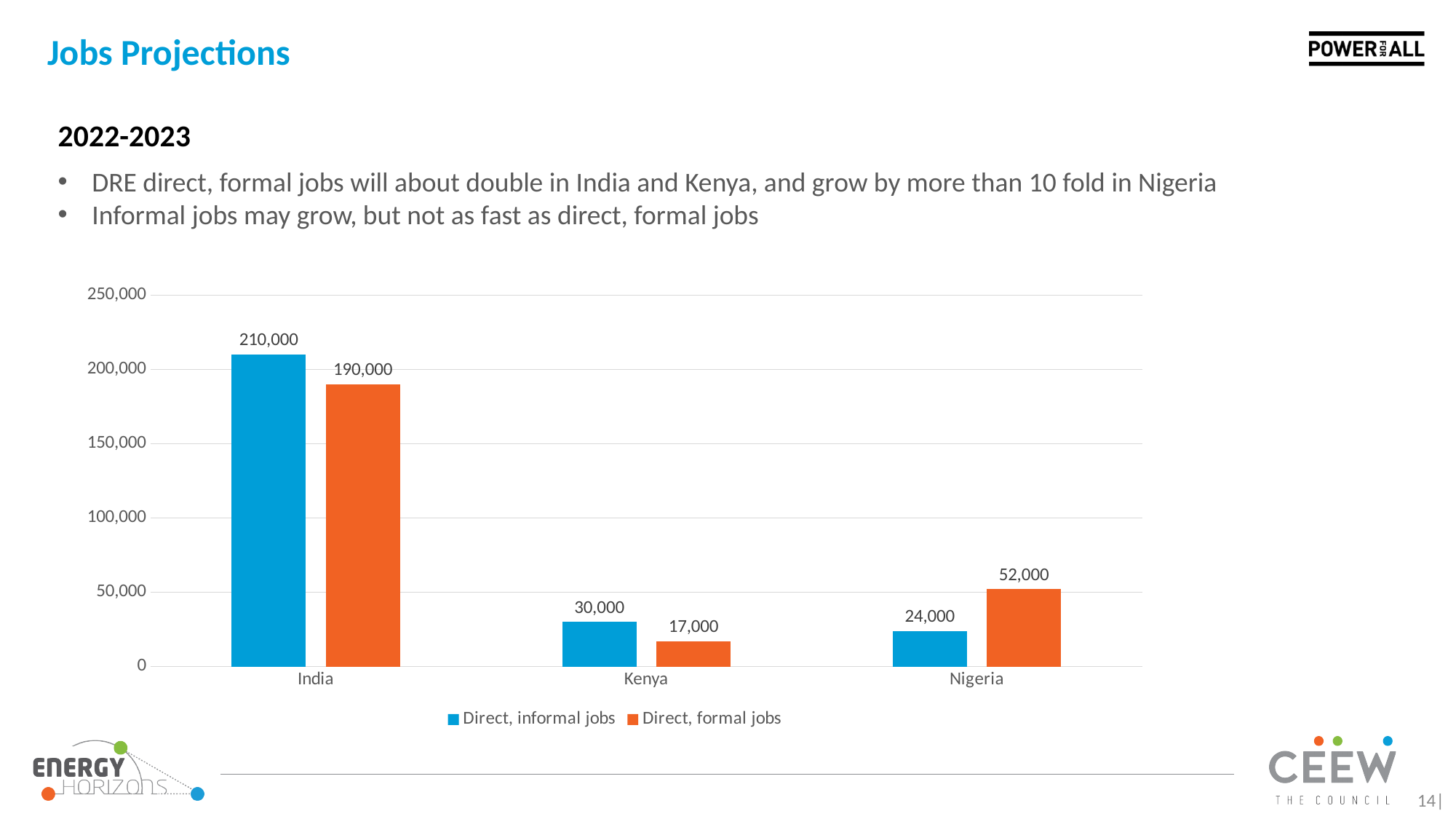
How many series does the chart legend list? 2 What is the value for Direct, formal jobs in Kenya? 17,000 What is the difference between Direct, informal jobs and Direct, formal jobs in India? 20,000 What is the value for Direct, formal jobs in Nigeria? 52,000 In Kenya, which is larger: Direct, informal jobs or Direct, formal jobs? Direct, informal jobs How many countries are shown on the x axis of the chart? 3 What is the difference between Direct, formal jobs and Direct, informal jobs in Nigeria? 28,000 Which country has the lowest value for Direct, informal jobs? Nigeria Which country has the highest value for Direct, formal jobs? India What is the value for Direct, informal jobs in India? 210,000 Is the value for Direct, formal jobs in India greater or less than 200,000? less What kind of chart is shown on the slide? Bar chart